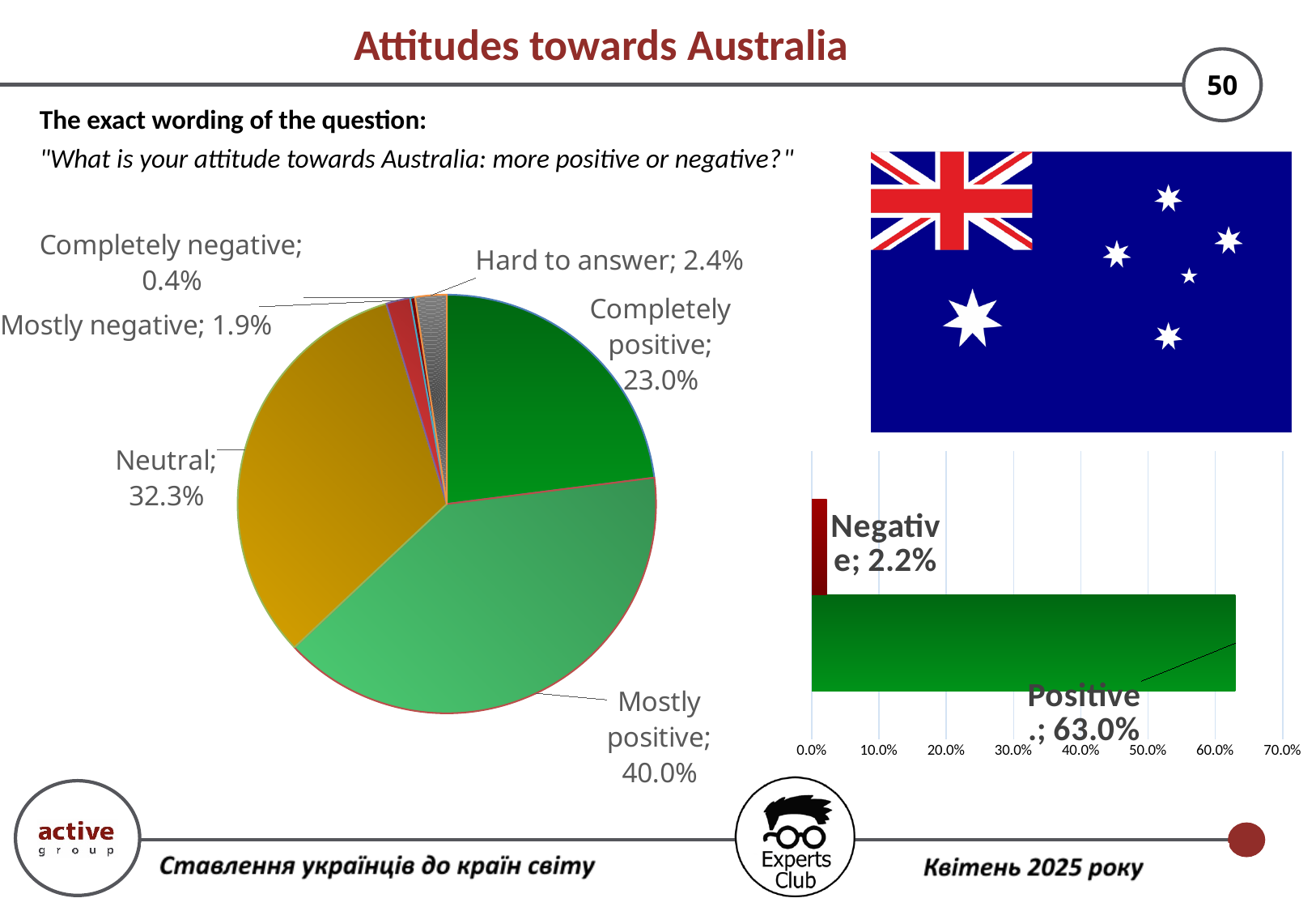
In the bar chart on the right, what is the difference between the "Positive" and "Negative" values? 60.8% In the pie chart on the left, what share of respondents answered "Mostly positive"? 40.0% In the pie chart on the left, what is the difference between the "Mostly positive" and "Completely positive" shares? 17.0% What type of chart is shown on the right side of the slide? Bar chart How many slices does the pie chart on the left have? 6 In the pie chart on the left, which is larger: "Hard to answer" or "Mostly negative"? Hard to answer In the pie chart on the left, which answer has the largest share? Mostly positive In the pie chart on the left, what share of respondents answered "Neutral"? 32.3% In the bar chart on the right, what is the value for "Negative"? 2.2% In the pie chart on the left, what share of respondents answered "Completely negative"? 0.4% In the pie chart on the left, which answer has the smallest share? Completely negative In the bar chart on the right, what is the value for "Positive"? 63.0%